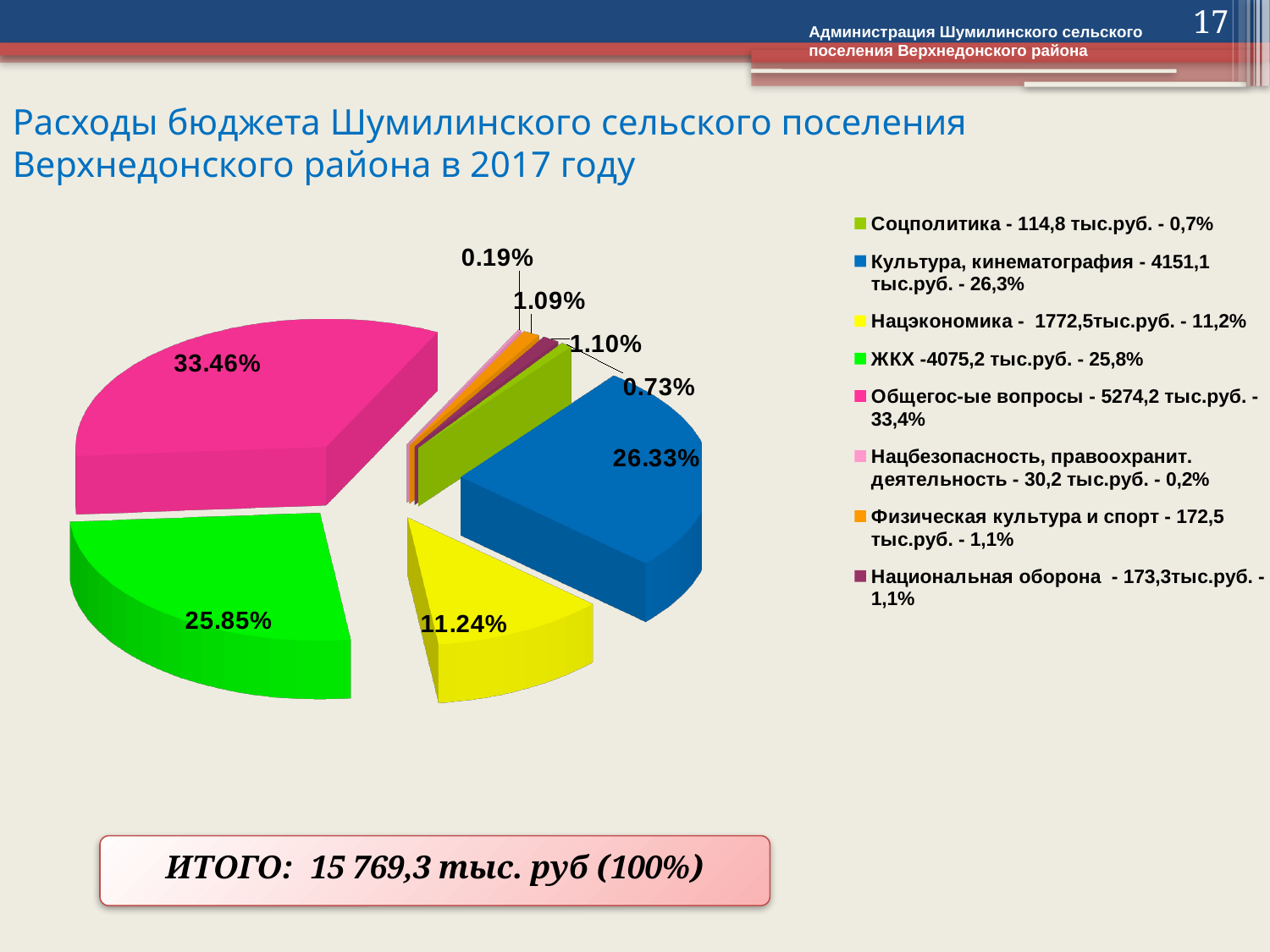
What percentage is shown on the pink slice (Общегос-ые вопросы)? 33.46% What percentage is shown on the green slice (ЖКХ)? 25.85% What percentage is shown on the yellow slice (Нацэкономика)? 11.24% Which slice is larger: ЖКХ or Нацэкономика? ЖКХ What kind of chart is shown on the slide? pie chart Which category has the smallest share of the pie? Нацбезопасность, правоохранит. деятельность According to the legend, what amount in тыс.руб. is spent on ЖКХ? 4075,2 тыс.руб. How many entries does the legend list? 8 What is the difference in percentage points between the pink slice (33.46%) and the blue slice (26.33%)? 7.13% What percentage is shown on the blue slice (Культура, кинематография)? 26.33% How many slices does the pie chart have? 8 Which category has the largest share of the pie? Общегос-ые вопросы